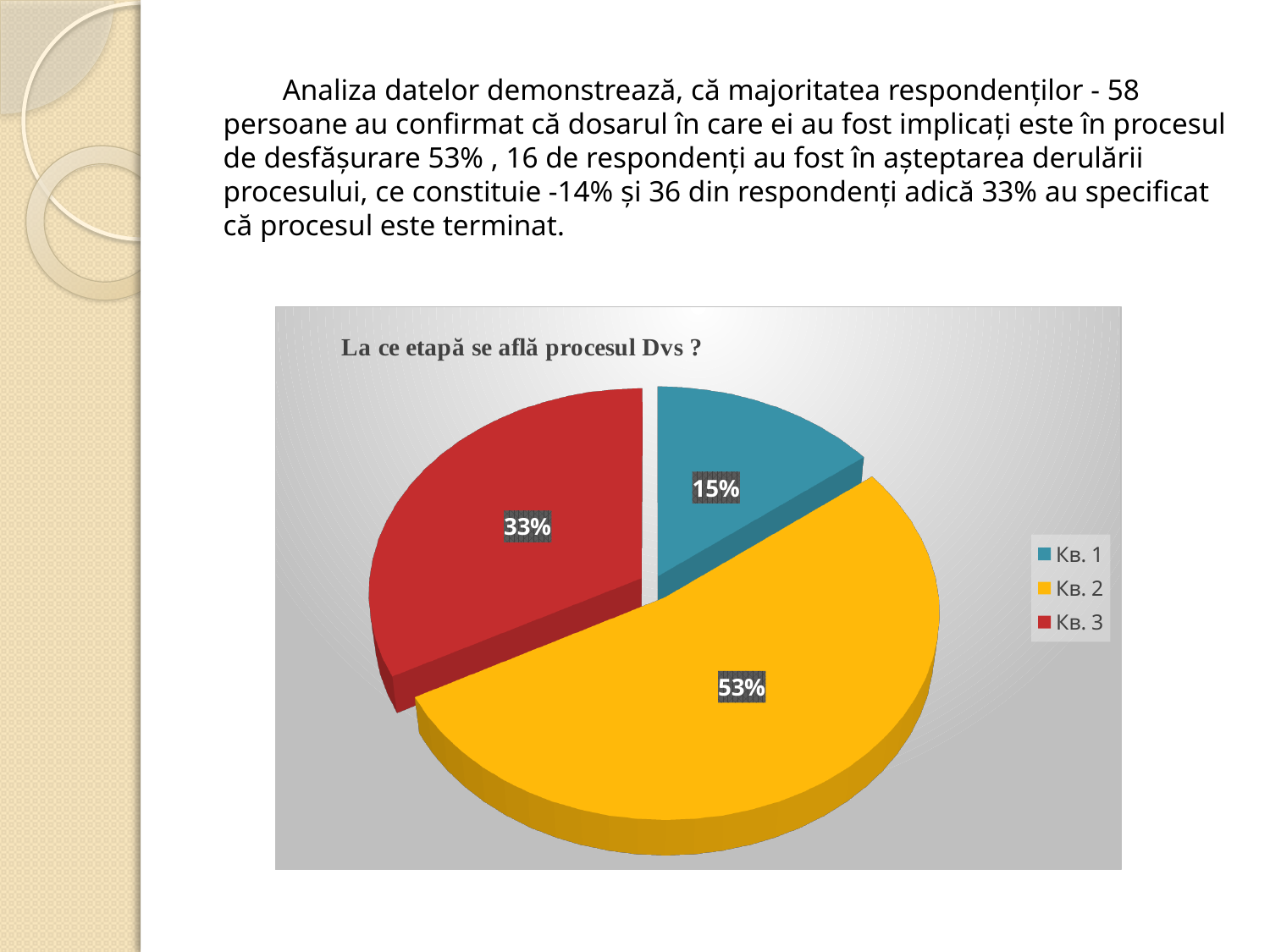
What kind of chart is shown on the slide? Pie chart What is the title of the chart? La ce etapă se află procesul Dvs ? How many entries does the chart legend list? 3 How many slices does the pie chart have? 3 What percentage is shown for the Кв. 1 slice? 15% What colour is the Кв. 2 slice? Yellow Which slice has the largest share of the pie? Кв. 2 What is the difference in percentage points between the Кв. 2 and Кв. 3 slices? 20 What percentage is shown for the Кв. 2 slice? 53% What percentage is shown for the Кв. 3 slice? 33% Which slice has the smallest share of the pie? Кв. 1 Which slice is larger, Кв. 1 or Кв. 3? Кв. 3